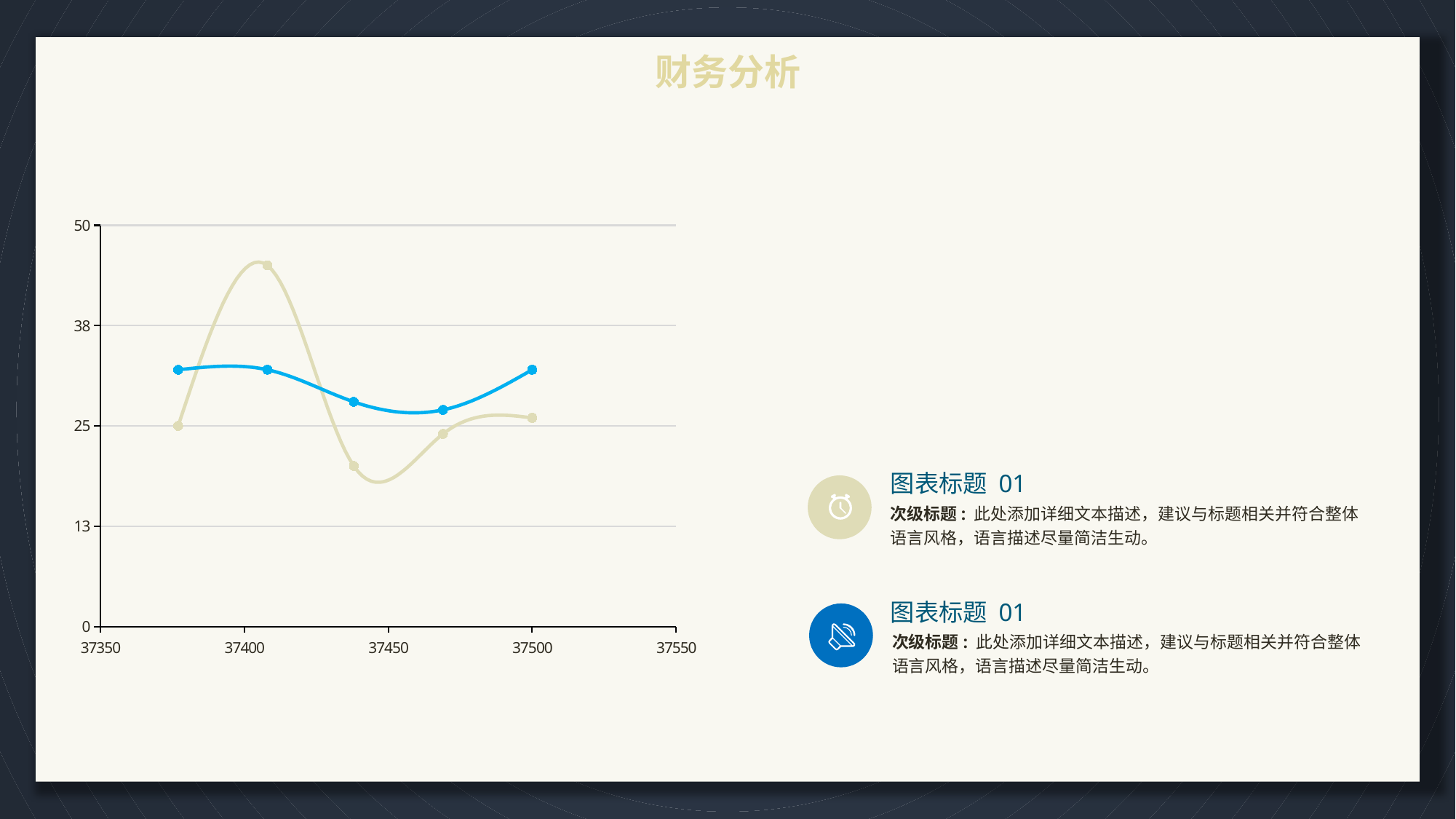
Is the lowest point of the beige line greater or less than 25? less Does the blue line rise or fall between its second and fourth points? fall What is the title of the slide containing the chart? 财务分析 Is the first point of the blue line greater or less than 25? greater How many data points does the beige line have? 5 What kind of chart is shown on the slide? line chart Is the highest point of the beige line greater or less than 38? greater Which line contains the lowest point on the chart, the blue line or the beige line? the beige line How many lines (series) are plotted on the chart? 2 Which line reaches the highest value on the chart, the blue line or the beige line? the beige line How many data points does the blue line have? 5